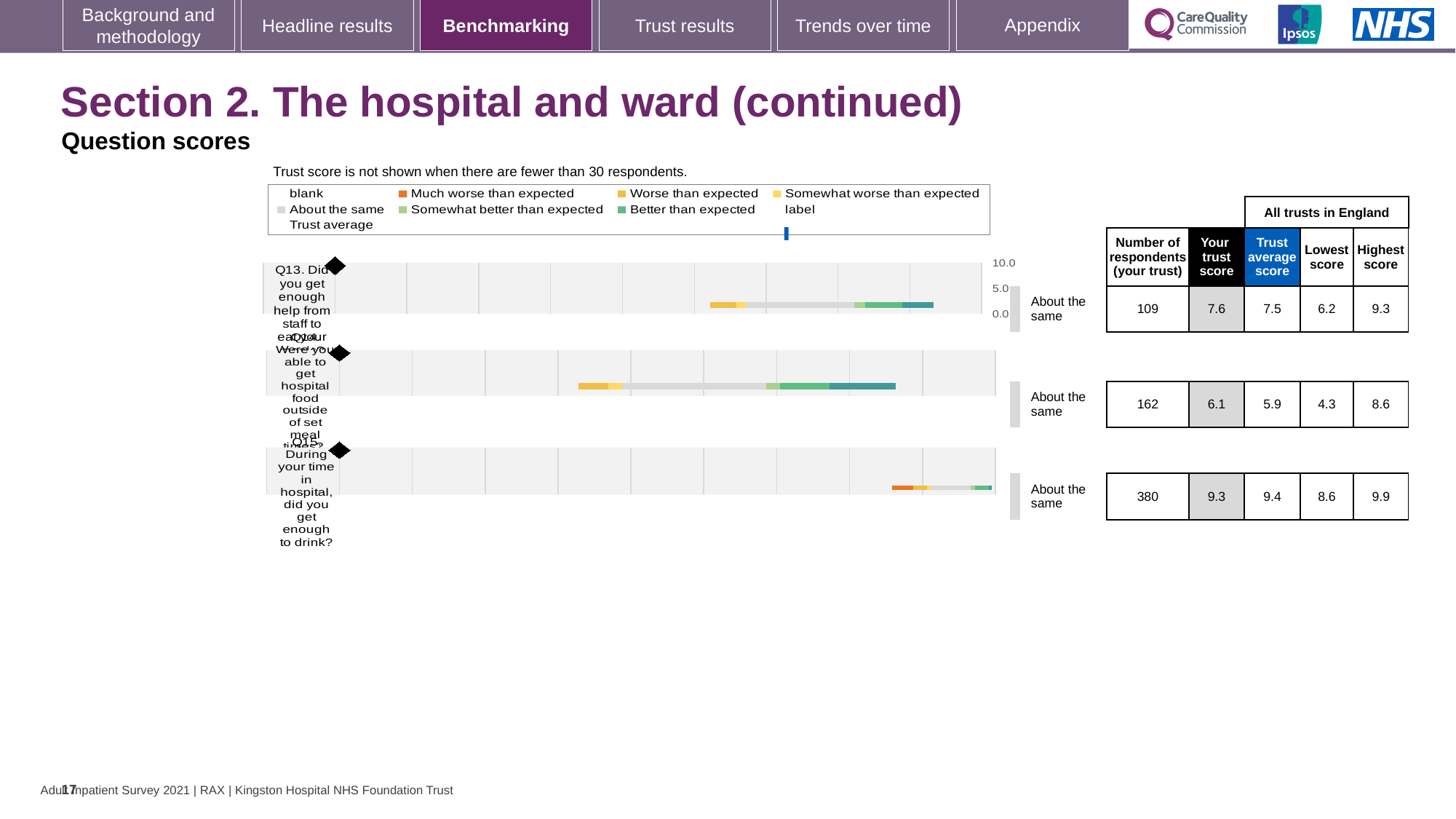
What kind of chart is used to show the question scores for Q13, Q14 and Q15? Bar chart According to the table, what is the 'Your trust score' for Q13 (Did you get enough help from staff to eat your meals)? 7.6 For Q14, which is larger: your trust score or the trust average score? Your trust score For Q13, what is the difference between the highest score (9.3) and the lowest score (6.2) across all trusts in England? 3.1 Which question has the highest 'Your trust score' in the table? Q15 Which question has the lowest 'Your trust score' in the table? Q14 What benchmark category is shown next to the Q13 chart? About the same How many questions (Q13, Q14, Q15) are plotted on the slide? 3 In the chart legend, what does the dark orange colour represent? Much worse than expected According to the table, how many respondents from your trust answered Q14 (Were you able to get hospital food outside of set meal times)? 162 According to the table, what is the trust average score for Q15 (did you get enough to drink)? 9.4 According to the table, what is the lowest score across all trusts in England for Q15? 8.6